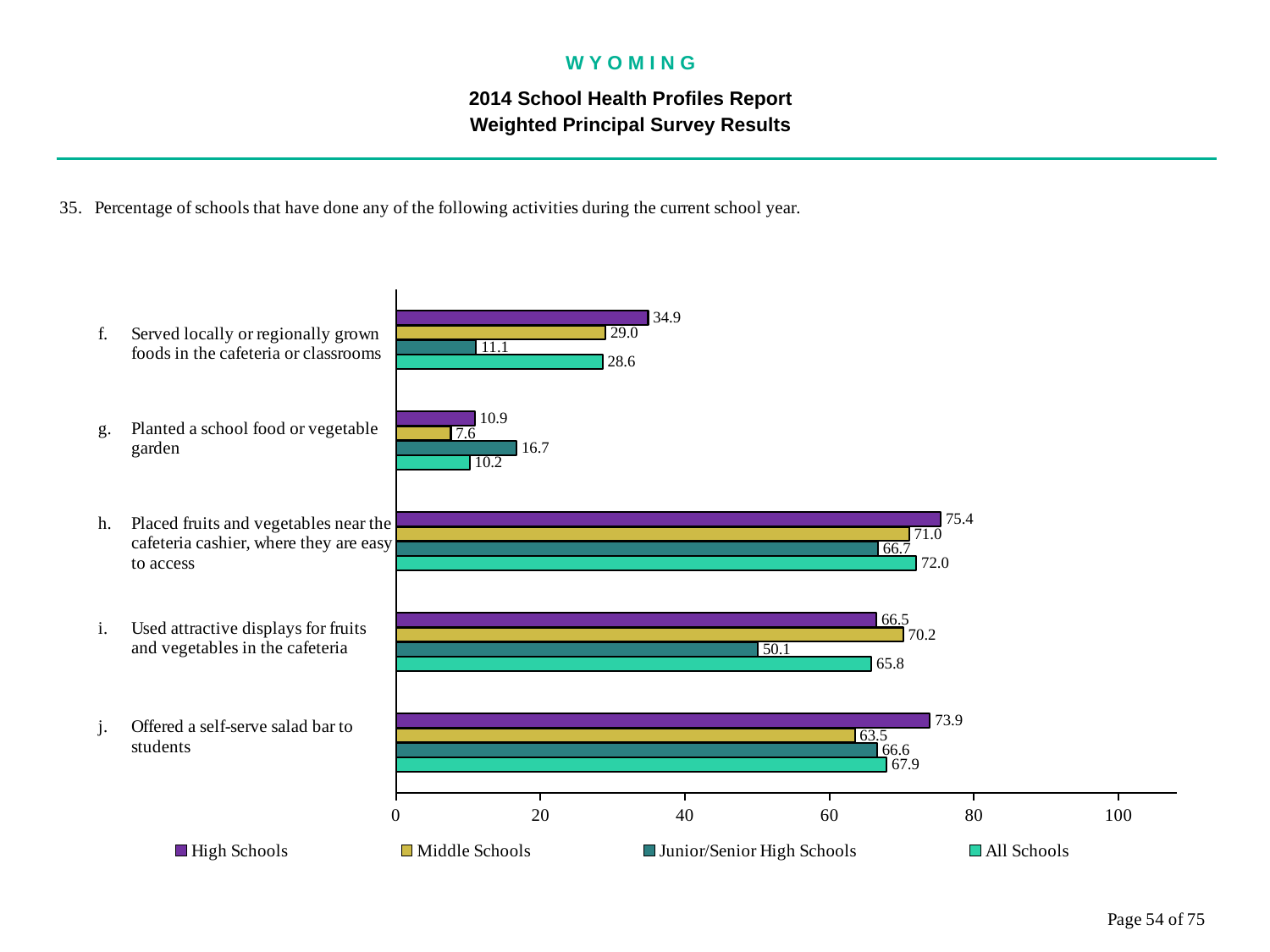
Which activity has the highest value for High Schools? Placed fruits and vegetables near the cafeteria cashier, where they are easy to access How many series does the legend list? 4 What is the value for Junior/Senior High Schools for 'Used attractive displays for fruits and vegetables in the cafeteria'? 50.1 How many activities (categories) are shown in the chart? 5 What is the difference between the High Schools and Middle Schools values for 'Offered a self-serve salad bar to students'? 10.4 What kind of chart is shown on the slide? Bar chart For 'Planted a school food or vegetable garden', which is larger: the Junior/Senior High Schools value or the High Schools value? Junior/Senior High Schools What is the value for High Schools for 'Served locally or regionally grown foods in the cafeteria or classrooms'? 34.9 Which activity has the lowest value for All Schools? Planted a school food or vegetable garden What is the value for Middle Schools for 'Planted a school food or vegetable garden'? 7.6 Which series is shown in the legend with the purple colour? High Schools What is the value for All Schools for 'Offered a self-serve salad bar to students'? 67.9